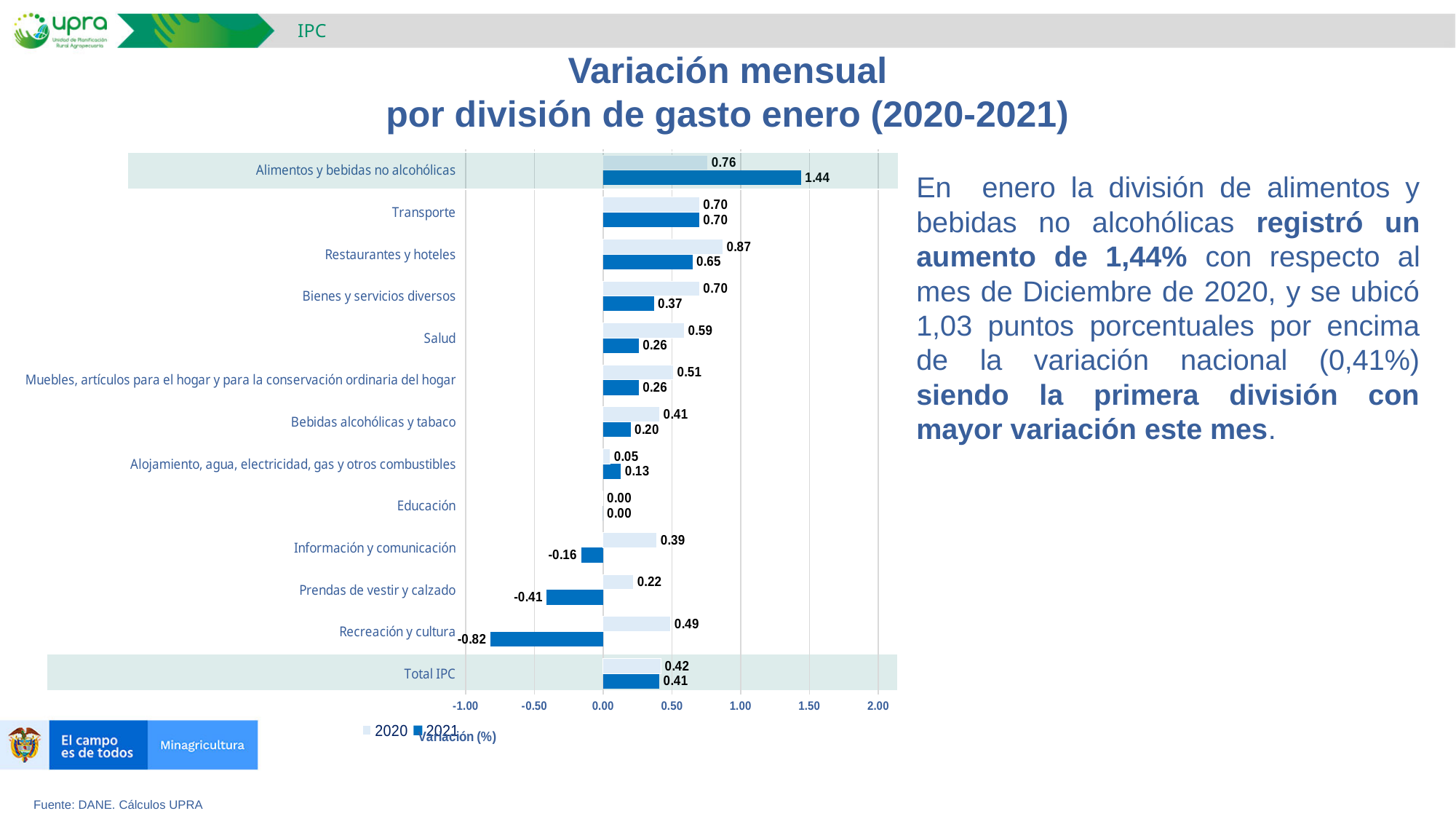
What is the 2021 value for Total IPC? 0.41 What kind of chart is shown on the slide? Bar chart What is the 2021 value for Recreación y cultura? -0.82 How many series does the legend list? 2 Which category has the highest 2021 value? Alimentos y bebidas no alcohólicas Which category has the lowest 2021 value? Recreación y cultura How many categories are shown on the chart? 13 What is the 2020 value for Restaurantes y hoteles? 0.87 What is the 2021 value for Alimentos y bebidas no alcohólicas? 1.44 Which category has the highest 2020 value? Restaurantes y hoteles What is the difference between the 2021 and 2020 values for Alimentos y bebidas no alcohólicas? 0.68 Which is larger for Bienes y servicios diversos, the 2020 value or the 2021 value? 2020